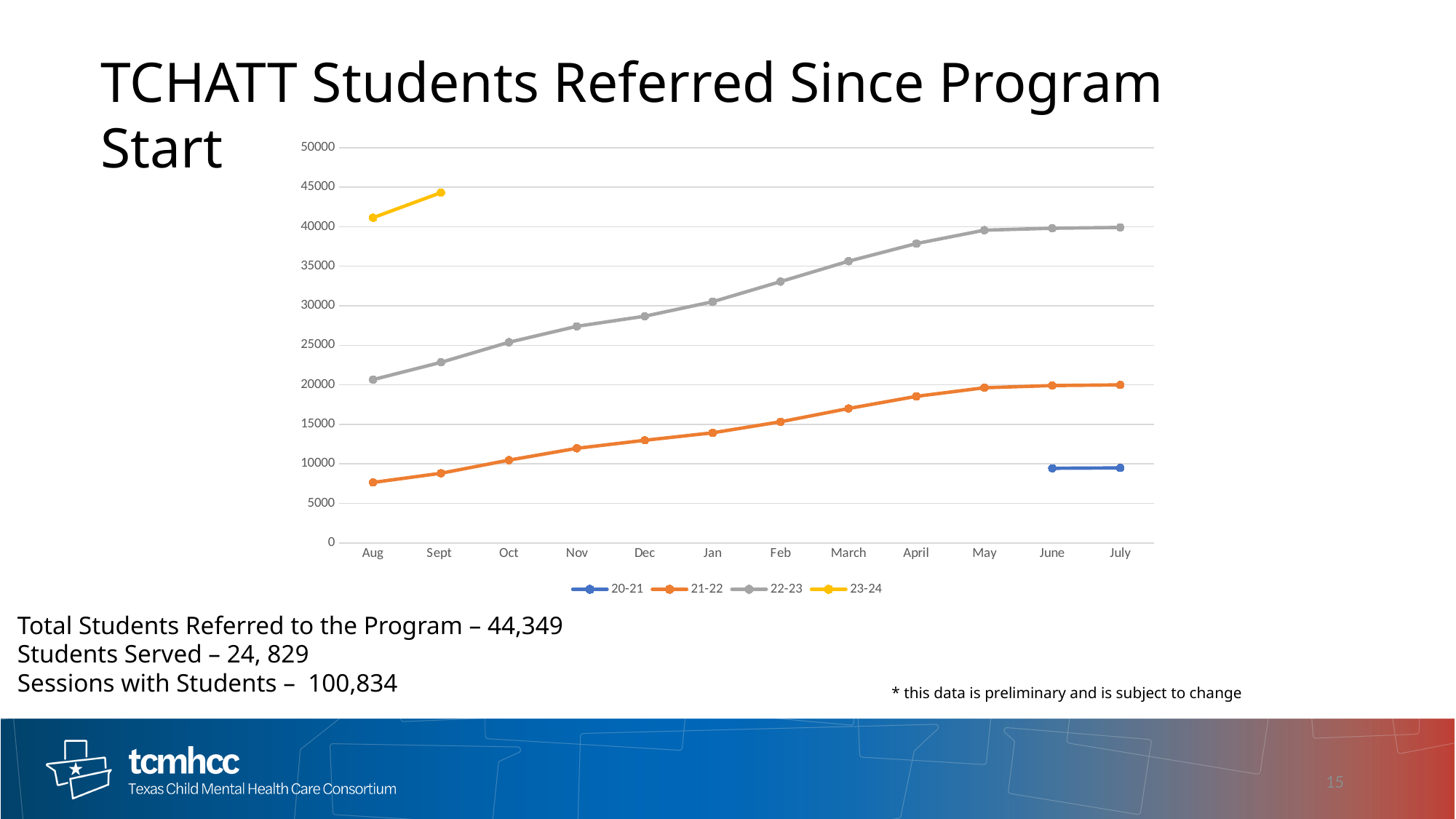
In Oct, which series has the larger value, 22-23 or 21-22? 22-23 Is the value for 20-21 in June greater or less than 10000? less What is the title of the chart on the slide? TCHATT Students Referred Since Program Start Which series has the lowest value in June? 20-21 Is the value for 22-23 in Feb greater or less than 30000? greater Does the 21-22 series rise or fall from Aug to May? rise How many series does the legend list? 4 Is the value for 23-24 in Sept greater or less than 45000? less What kind of chart is shown on the slide? line chart Which series has the highest value in Aug? 23-24 How many months are shown along the x axis? 12